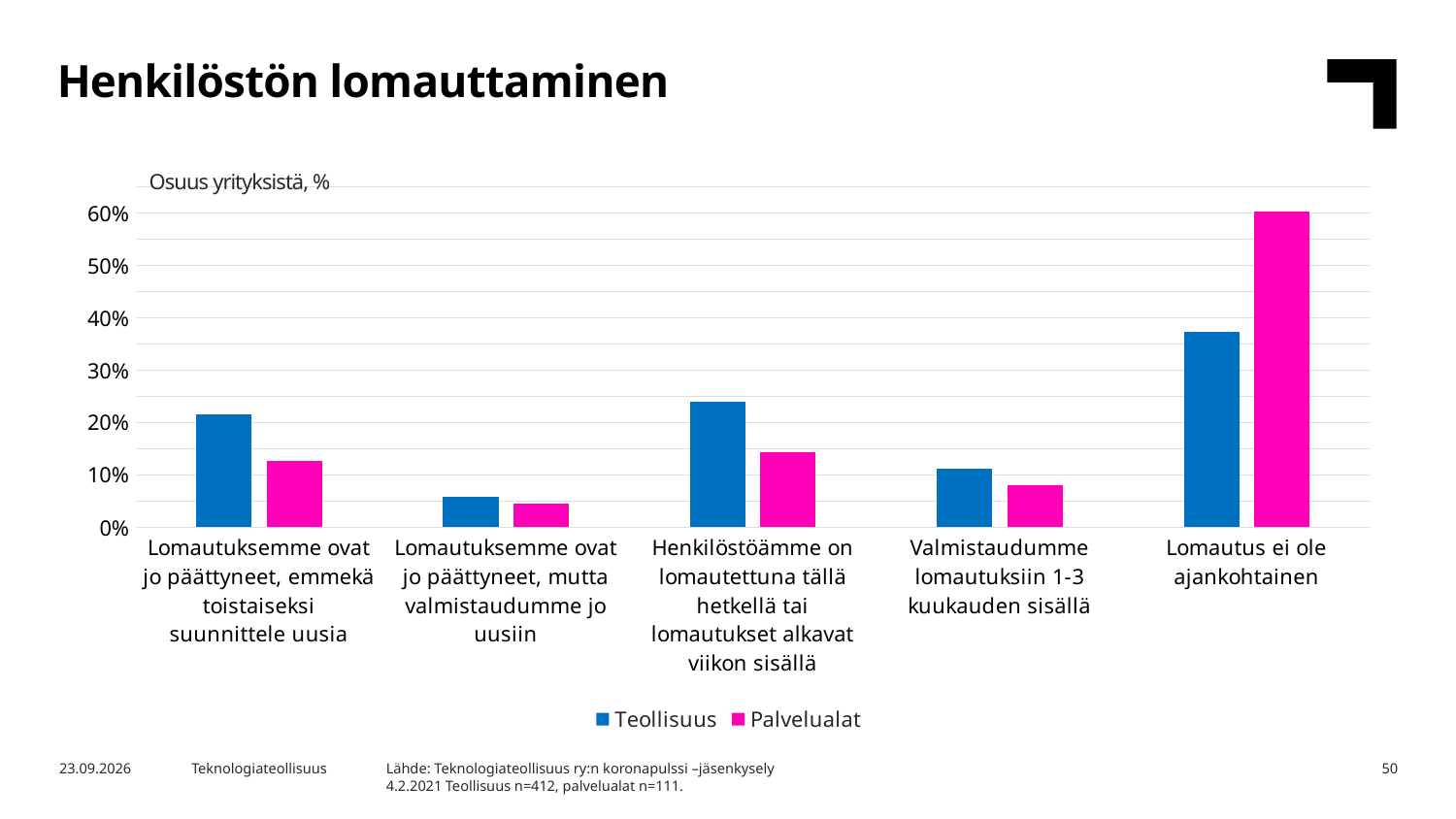
Is the value for Teollisuus in the category 'Lomautus ei ole ajankohtainen' greater or less than 40%? less How many series does the legend list? 2 Which category has the lowest value for Teollisuus? Lomautuksemme ovat jo päättyneet, mutta valmistaudumme jo uusiin What is the title of the slide? Henkilöstön lomauttaminen In the category 'Lomautuksemme ovat jo päättyneet, emmekä toistaiseksi suunnittele uusia', which series has the larger value, Teollisuus or Palvelualat? Teollisuus Is the value for Palvelualat in the category 'Lomautus ei ole ajankohtainen' greater or less than 50%? greater What kind of chart is shown on the slide? bar chart Is the value for Palvelualat in the category 'Valmistaudumme lomautuksiin 1-3 kuukauden sisällä' greater or less than 10%? less Which category has the highest value for Palvelualat? Lomautus ei ole ajankohtainen How many categories are shown on the x axis? 5 In the category 'Lomautus ei ole ajankohtainen', which series has the larger value, Teollisuus or Palvelualat? Palvelualat